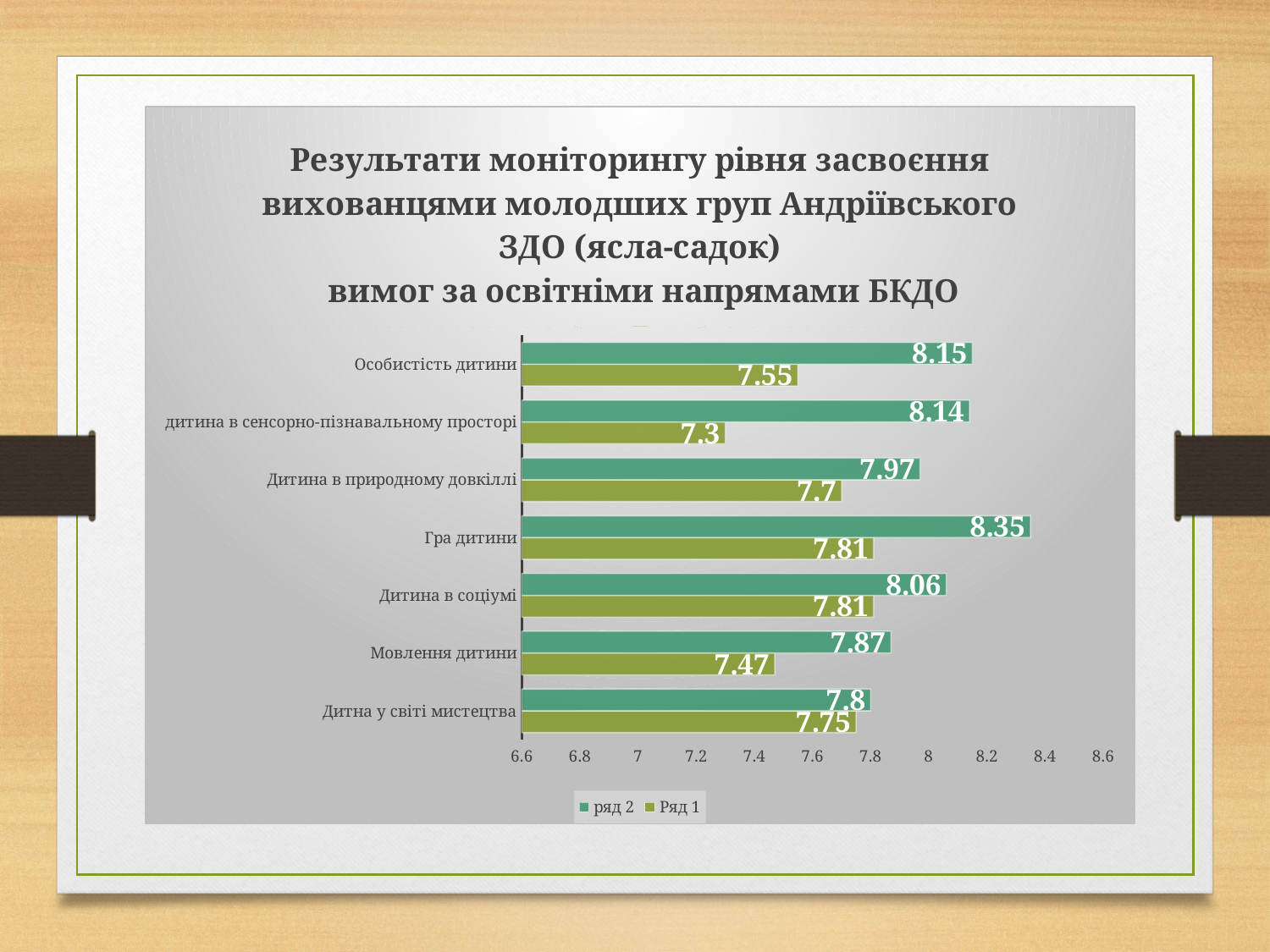
What are the two legend entries of the chart? ряд 2 and Ряд 1 How many series does the legend list? 2 What is the value of Ряд 1 for дитина в сенсорно-пізнавальному просторі? 7.3 Which category has the highest value for ряд 2? Гра дитини How many categories are shown on the chart? 7 Which category has the lowest value for ряд 2? Дитна у світі мистецтва Which category has the lowest value for Ряд 1? дитина в сенсорно-пізнавальному просторі What is the value of Ряд 1 for Мовлення дитини? 7.47 Which is larger for Дитина в природному довкіллі: ряд 2 or Ряд 1? ряд 2 What is the value of ряд 2 for Гра дитини? 8.35 What is the difference between ряд 2 and Ряд 1 for Особистість дитини? 0.6 What type of chart is shown on the slide? bar chart